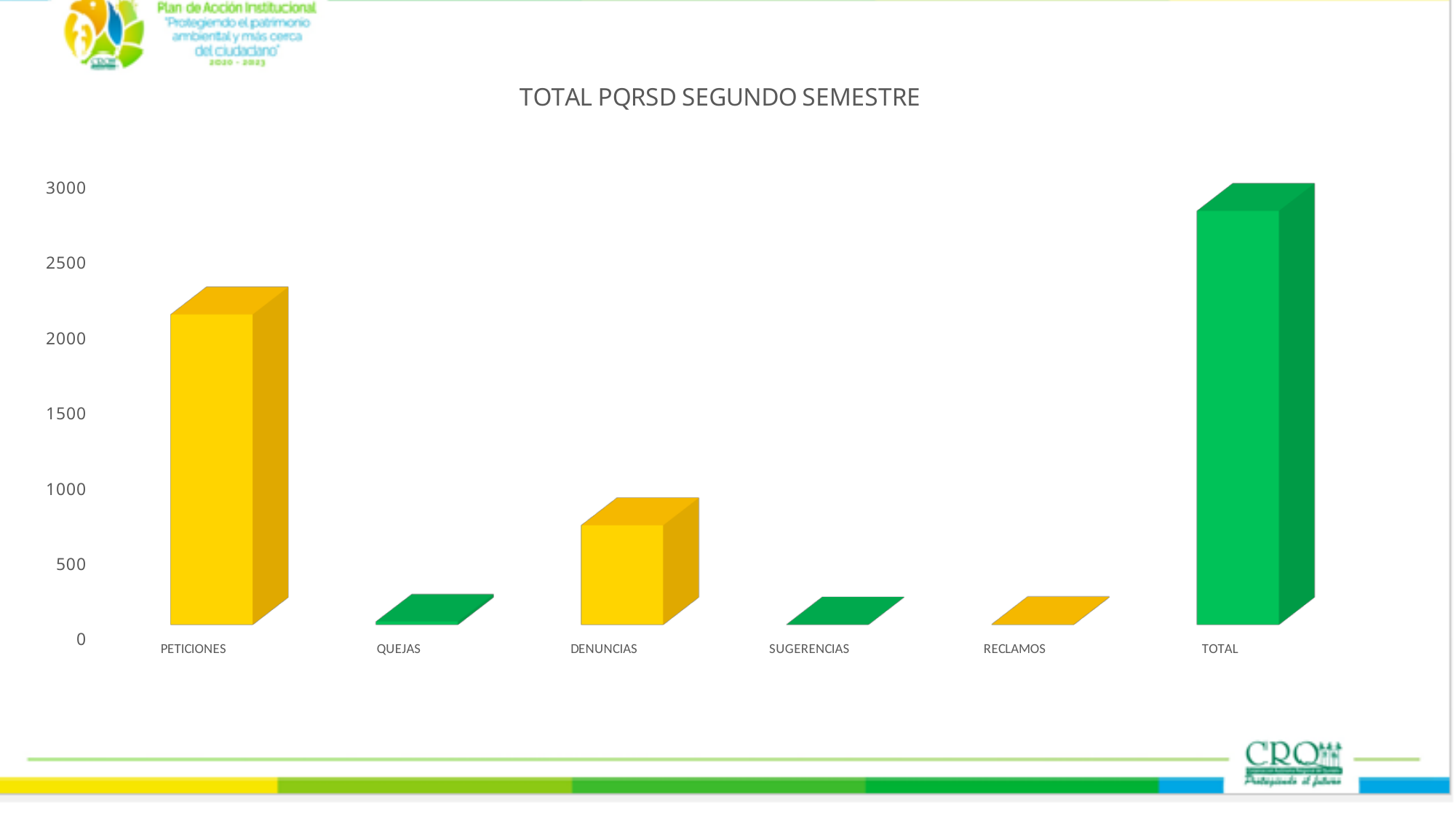
Is the value for QUEJAS greater or less than 500? less Is the value for PETICIONES greater or less than 2000? greater Is the value for PETICIONES greater or less than 2500? less Which category has the tallest bar in the chart? TOTAL Which is larger, the value for PETICIONES or the value for DENUNCIAS? PETICIONES What kind of chart is shown on the slide? bar chart What is the title of the chart? TOTAL PQRSD SEGUNDO SEMESTRE Which is larger, the value for TOTAL or the value for PETICIONES? TOTAL How many categories are shown on the x axis of the chart? 6